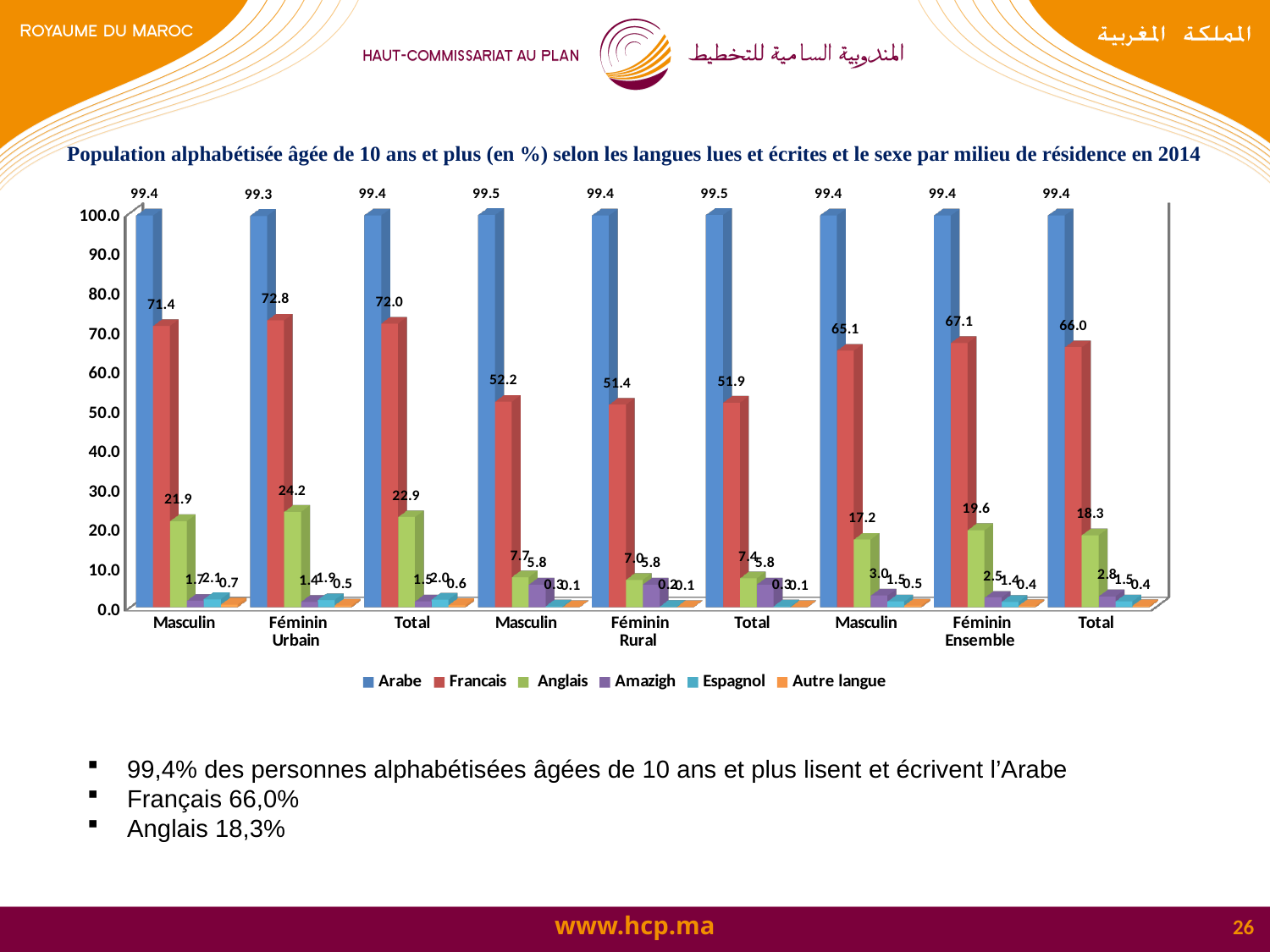
What kind of chart is shown on the slide? Bar chart What is the value for Anglais for Total in the Ensemble group? 18.3 What is the value for Francais for Masculin in the Urbain group? 71.4 What is the value for Arabe for Masculin in the Rural group? 99.5 Which language series has the highest value for Total in the Ensemble group? Arabe Which colour represents the Anglais series in the chart? Green What is the value for Francais for Total in the Rural group? 51.9 Is the Anglais value for Masculin in the Rural group greater or less than 10.0? less How many series does the legend list? 6 Which is larger, the Francais value for Féminin in the Ensemble group or for Masculin in the Ensemble group? Féminin (67.1) What is the difference between the Francais values for Total in the Urbain group and Total in the Rural group? 20.1 What is the value for Anglais for Féminin in the Urbain group? 24.2